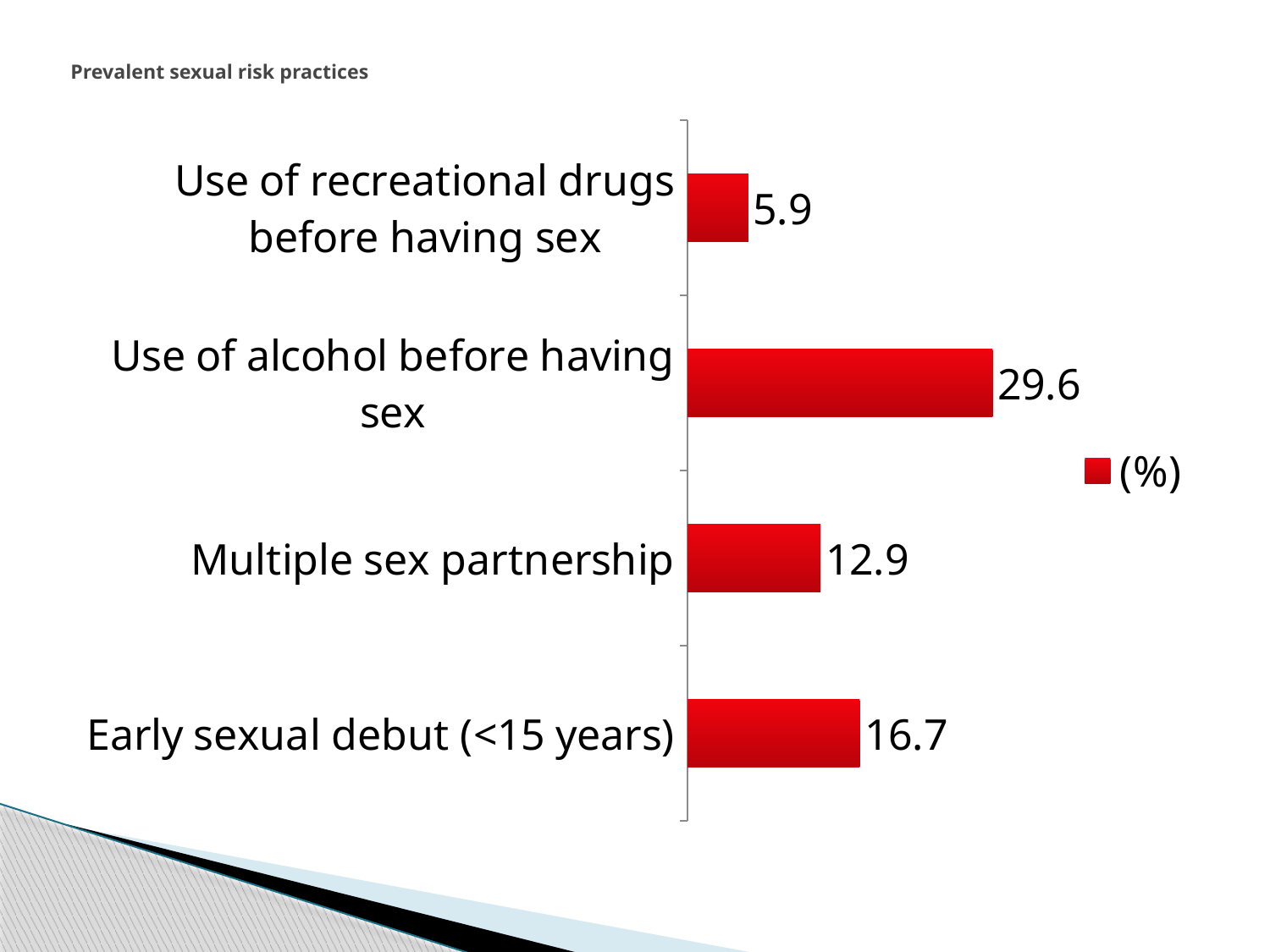
Which is larger: the value for Early sexual debut (<15 years) or Multiple sex partnership? Early sexual debut (<15 years) How many categories are shown in the chart? 4 What is the value for Early sexual debut (<15 years)? 16.7 What is the value for Use of alcohol before having sex? 29.6 What is the value for Multiple sex partnership? 12.9 What is the difference between the values for Early sexual debut (<15 years) and Use of recreational drugs before having sex? 10.8 What is the value for Use of recreational drugs before having sex? 5.9 Which category has the lowest value? Use of recreational drugs before having sex What kind of chart is shown on the slide? Bar chart What is the legend entry shown in the chart? (%) Which category has the highest value? Use of alcohol before having sex What is the difference between the values for Use of alcohol before having sex and Multiple sex partnership? 16.7